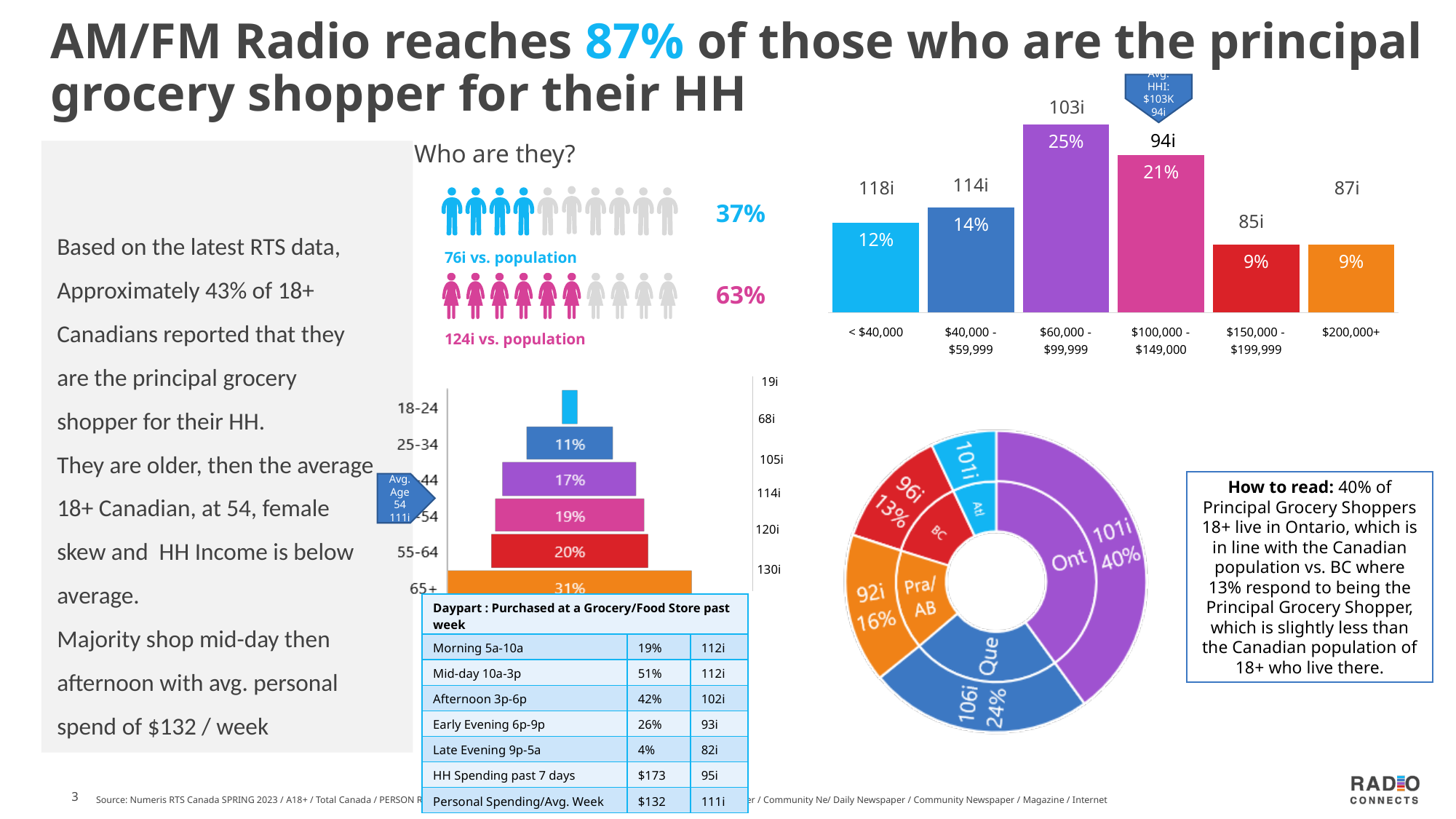
In the household income bar chart, what index value is shown above the < $40,000 bar? 118i In the age pyramid chart, do the percentages rise or fall as age increases from 25-34 to 65+? rise In the age pyramid chart, what percentage is shown for the 65+ age group? 31% In the household income bar chart, what is the difference between the percentages for $100,000 - $149,000 and < $40,000? 9% In the household income bar chart, how many income categories are shown? 6 In the household income bar chart, which income category has the highest percentage? $60,000 - $99,999 In the household income bar chart, what percentage is shown for the $60,000 - $99,999 category? 25% In the regional donut chart, what index value is shown for BC? 96i In the 'Who are they?' pictogram, what percentage of principal grocery shoppers are female? 63% In the regional donut chart, which region has the largest share? Ont In the regional donut chart, what share of principal grocery shoppers live in Quebec (Que)? 24% In the age pyramid chart, which labelled age group has the smallest percentage? 25-34